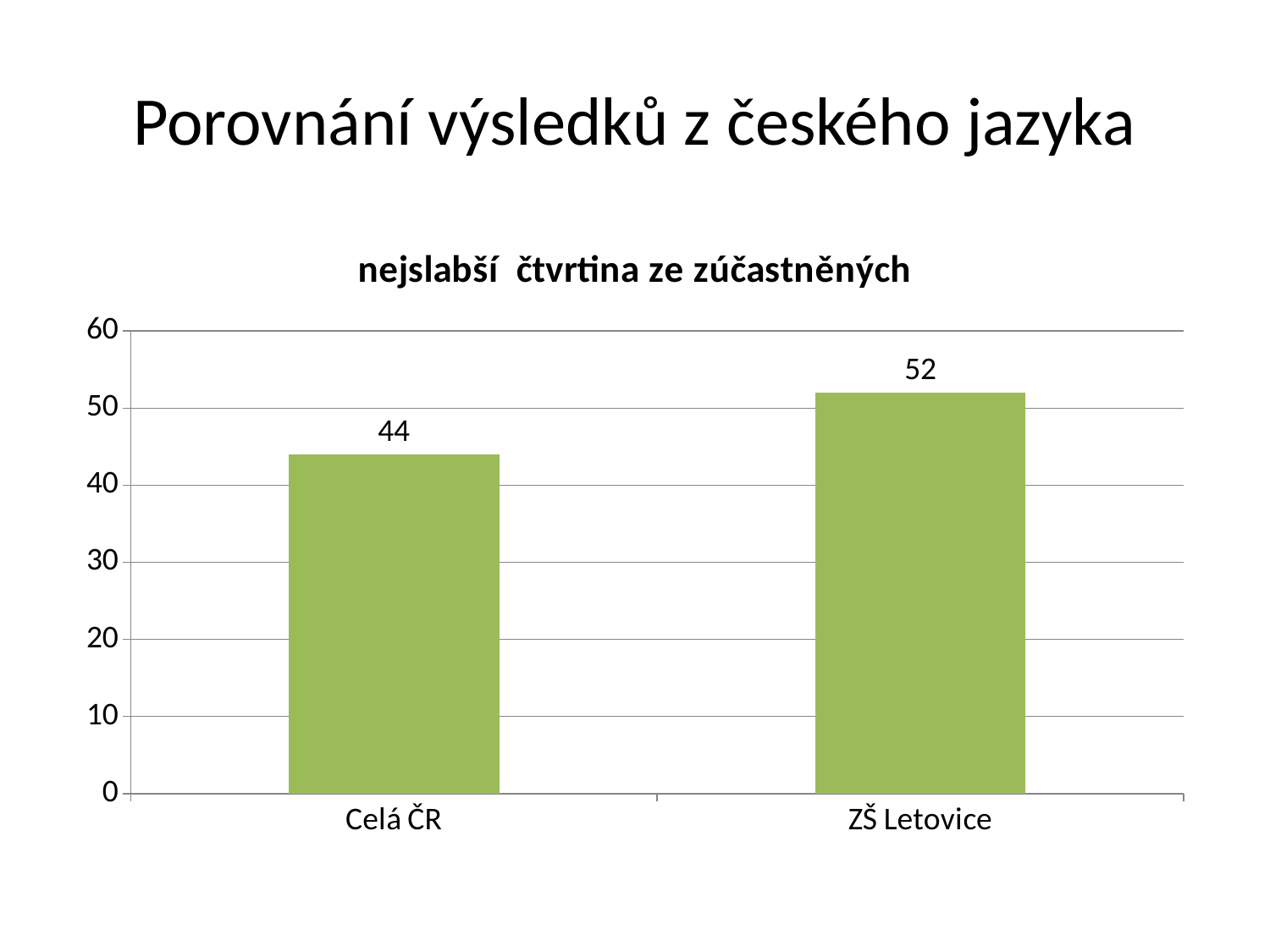
What is the value for Celá ČR? 44 What is the value for ZŠ Letovice? 52 What is the maximum value shown on the vertical axis? 60 What is the title of the chart? nejslabší čtvrtina ze zúčastněných Is the value for ZŠ Letovice greater or less than 50? greater How many categories are shown in the chart? 2 Is the value for Celá ČR greater or less than 50? less Which category has the highest value? ZŠ Letovice Which is larger, the value for Celá ČR or the value for ZŠ Letovice? ZŠ Letovice Which category has the lowest value? Celá ČR What kind of chart is shown on the slide? bar chart What is the difference between the values for ZŠ Letovice and Celá ČR? 8